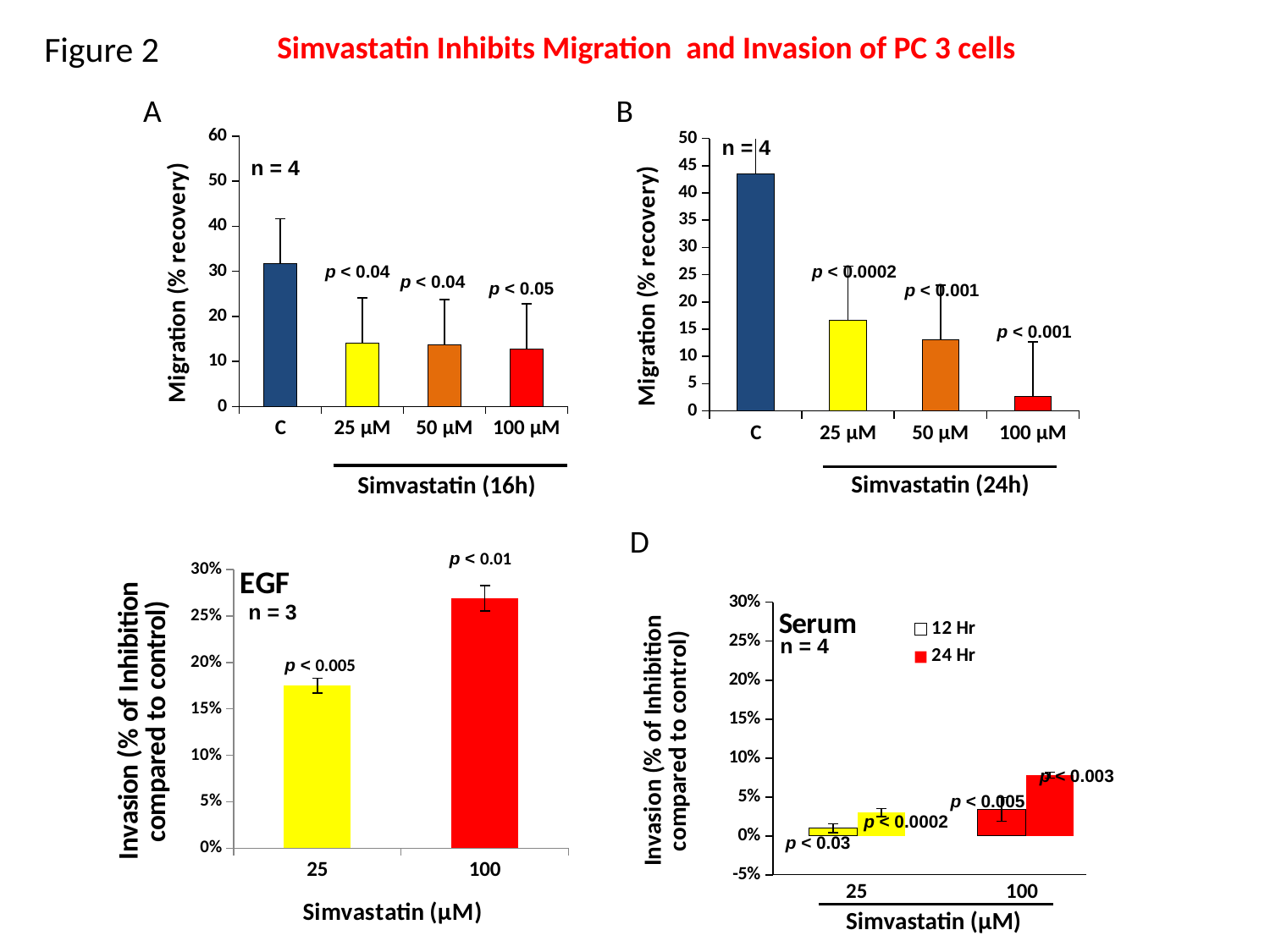
In chart B (Simvastatin 24h), what p-value label is printed above the 100 µM bar? p < 0.001 In the Serum invasion chart (D), how many series does the legend list? 2 In chart B (Simvastatin 24h), is the value for C greater or less than 40? greater In chart B (Simvastatin 24h), which category has the lowest migration (% recovery)? 100 µM In chart A (Simvastatin 16h), how many bars are plotted? 4 What kind of chart is chart A (Simvastatin 16h)? bar chart In the Serum invasion chart (D), is the 24 Hr value at 100 greater or less than 5%? greater In the EGF invasion chart (bottom left), is the value for 100 greater or less than 25%? greater In the EGF invasion chart (bottom left), which is larger, the value for 25 or the value for 100? 100 In chart A (Simvastatin 16h), which category has the highest migration (% recovery)? C In chart B (Simvastatin 24h), do the migration values rise or fall from C to 100 µM? fall